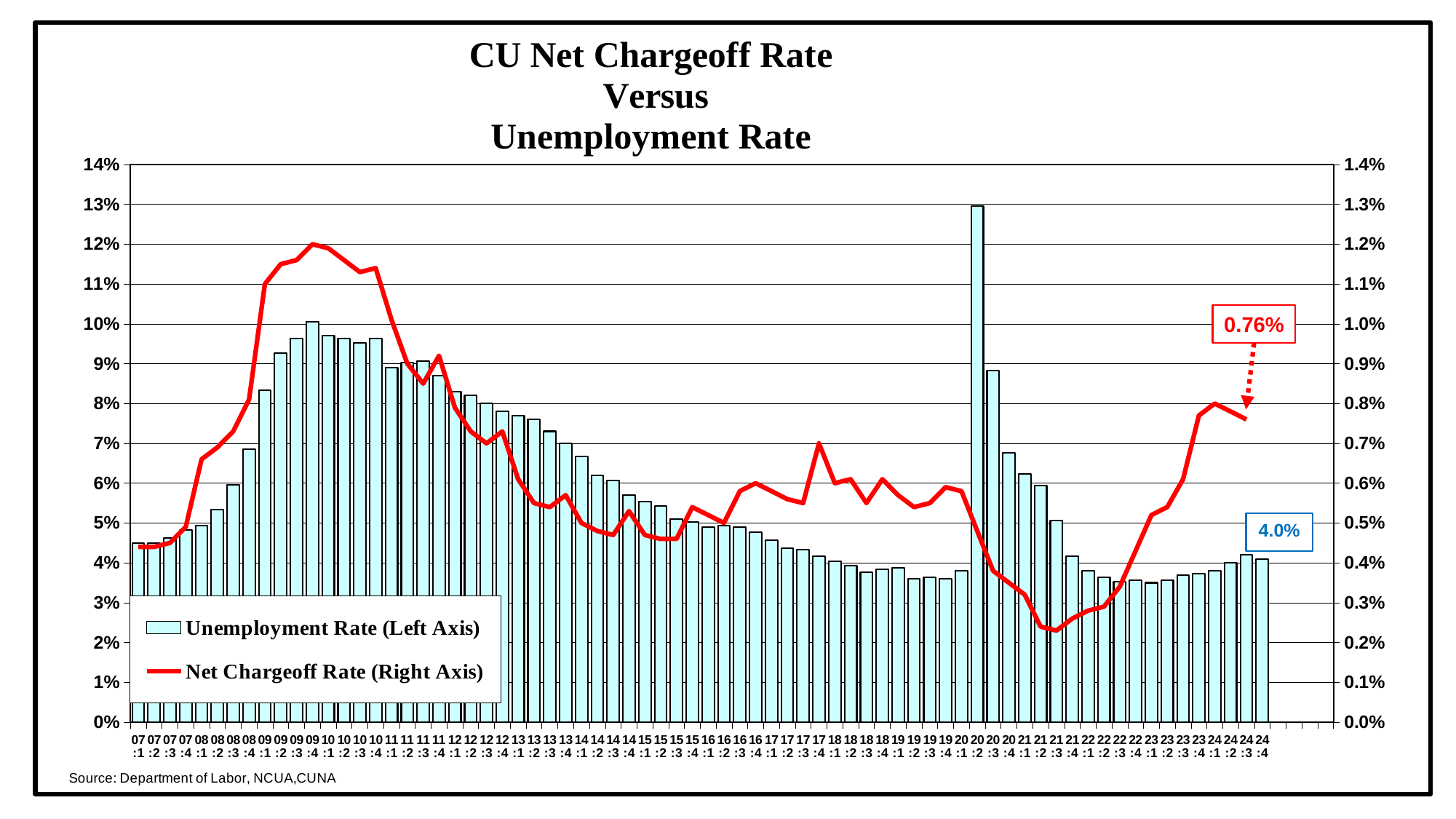
How many series does the legend list? 2 Which quarter has the highest Unemployment Rate? 20:2 Is the Net Chargeoff Rate for 21:3 greater or less than 0.3%? less Is the Unemployment Rate for 20:2 greater or less than 12%? greater Which series is plotted on the right axis according to the legend? Net Chargeoff Rate What is the title of the chart? CU Net Chargeoff Rate Versus Unemployment Rate What kind of chart is this? Combined bar and line chart Which is larger, the Unemployment Rate for 09:4 or for 24:4? 09:4 Does the Unemployment Rate rise or fall from 10:1 to 19:4? fall Is the Net Chargeoff Rate for 09:4 greater or less than 1.0%? greater